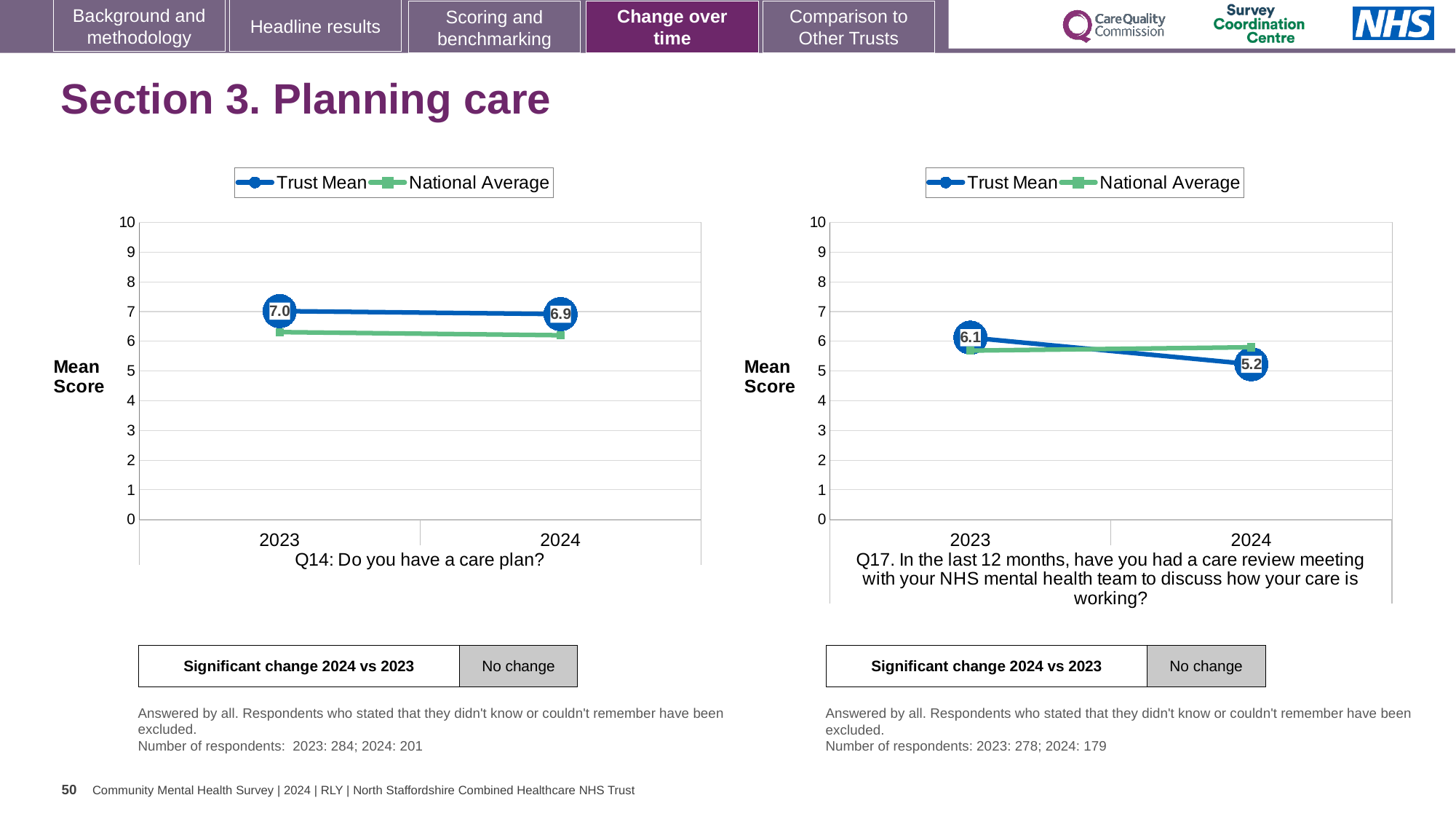
In the Q17 care review meeting chart, what is the Trust Mean score for 2023? 6.1 In the Q14 care plan chart, what is the difference between the Trust Mean in 2023 and 2024? 0.1 What type of chart is used for the Q14 care plan data? line chart In the Q17 care review meeting chart, does the Trust Mean rise or fall from 2023 to 2024? fall In the Q14 care plan chart, what is the Trust Mean score for 2024? 6.9 In the Q17 care review meeting chart, by how much did the Trust Mean fall from 2023 to 2024? 0.9 In the Q17 care review meeting chart, which is higher in 2024, the Trust Mean or the National Average? National Average How many series does the legend of the Q14 care plan chart list? 2 In the Q17 care review meeting chart, is the National Average for 2024 greater or less than 5? greater In the Q14 care plan chart, is the National Average for 2023 greater or less than 7? less In the Q14 care plan chart, what is the Trust Mean score for 2023? 7.0 In the Q17 care review meeting chart, what is the Trust Mean score for 2024? 5.2